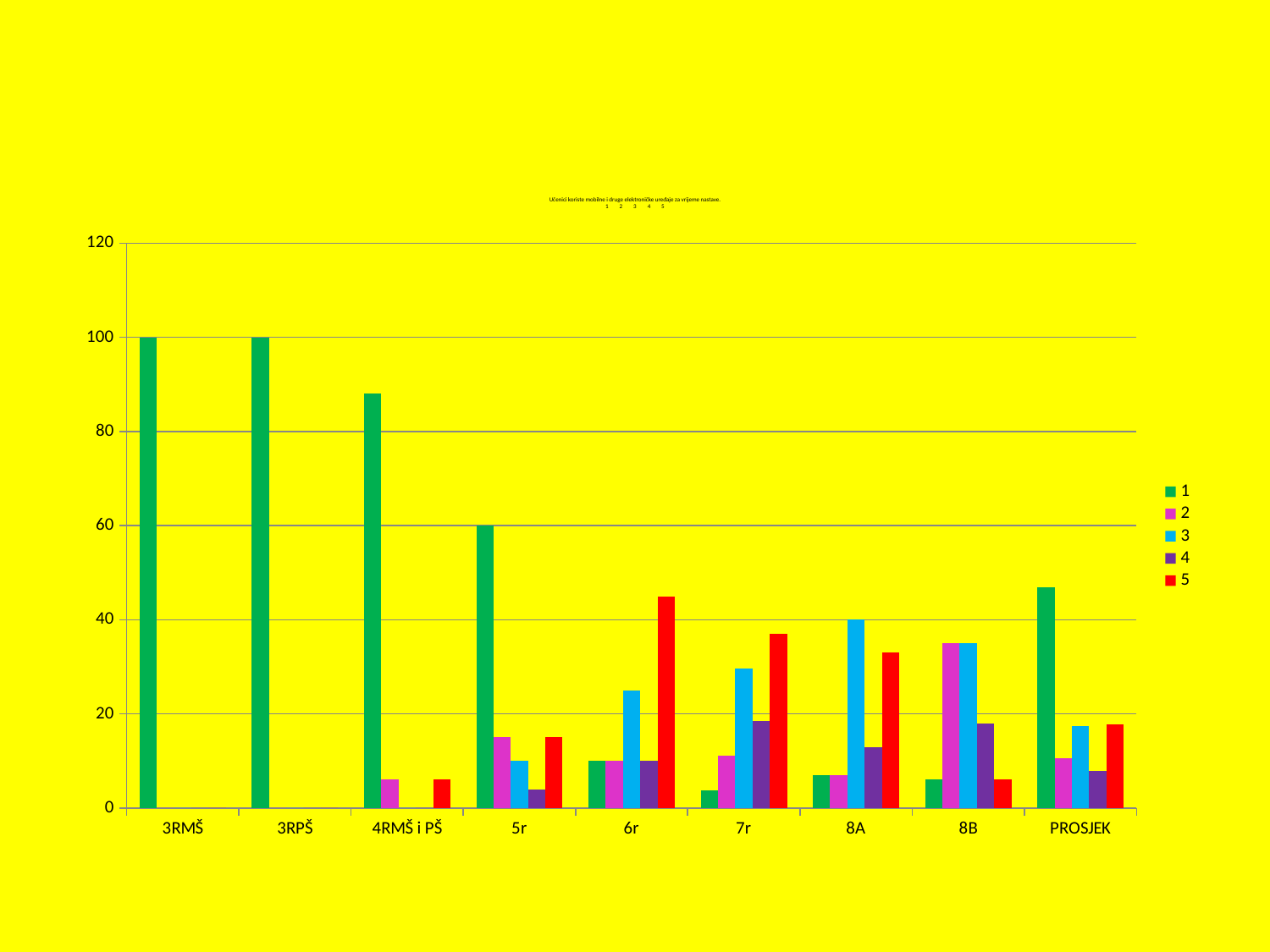
How many categories are shown on the x axis of the chart? 9 What is the value of series 3 for 8A? 40 How many series does the legend list? 5 Is the value of series 1 for 4RMŠ i PŠ greater or less than 80? greater Is the value of series 1 for PROSJEK greater or less than 40? greater What are the entries listed in the legend? 1, 2, 3, 4, 5 What is the value of series 1 for 3RMŠ? 100 What is the value of series 1 for 5r? 60 Which category has the highest value for series 5? 6r What kind of chart is shown on the slide? bar chart Is the value of series 5 for 6r greater or less than 40? greater Which is larger: series 2 for 8B or series 2 for 8A? 8B